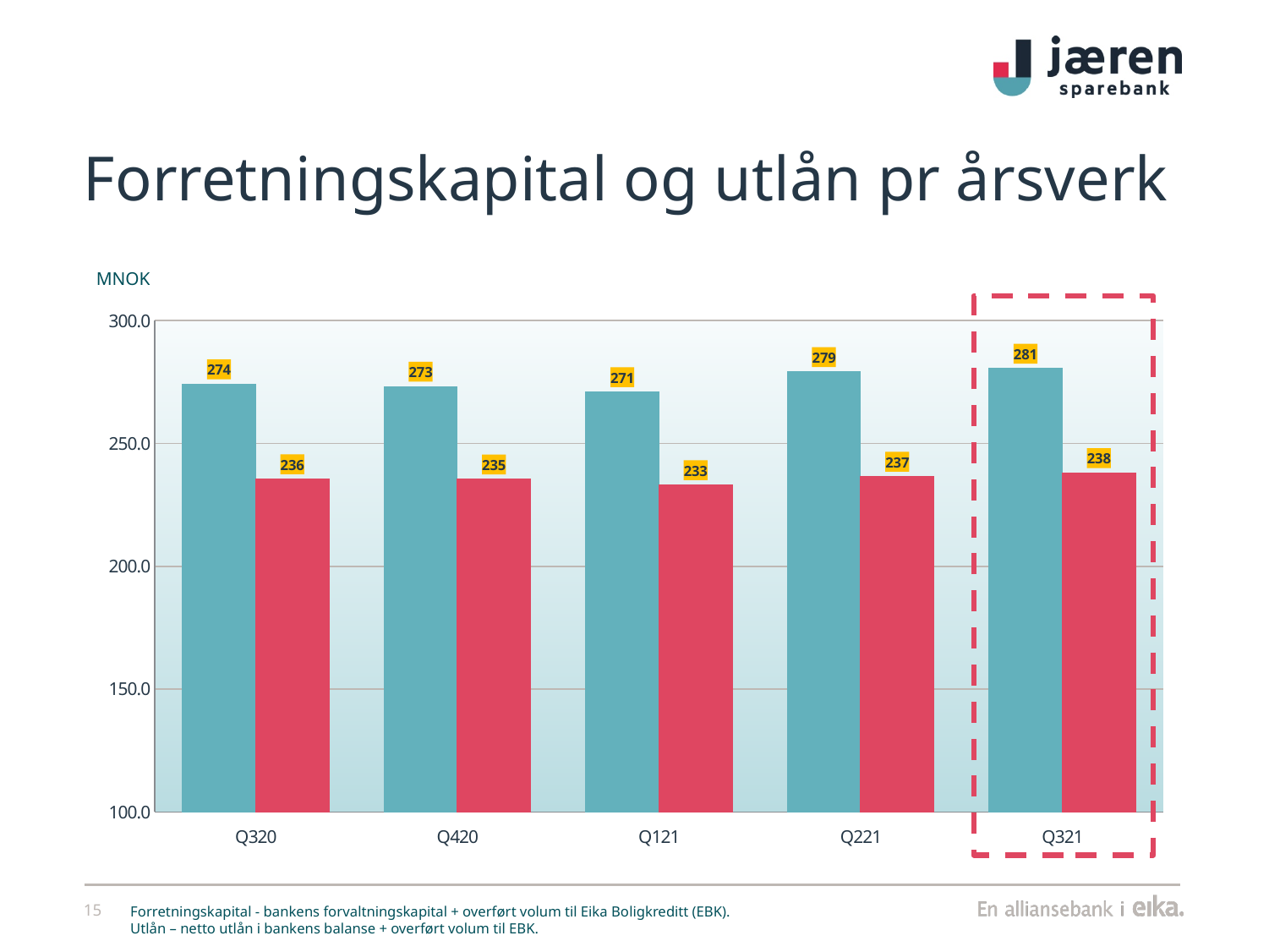
What is the value of the teal bar for Q321? 281 What unit is shown above the chart's y axis? MNOK How many quarters are shown on the x axis? 5 What kind of chart is shown on the slide? Bar chart What is the difference between the teal bar values for Q221 and Q121? 8 Which is larger, the teal bar for Q420 or the teal bar for Q221? Q221 Which quarter has the lowest red bar? Q121 What is the difference between the teal bar and the red bar for Q321? 43 What is the value of the teal bar for Q221? 279 What is the value of the red bar for Q320? 236 What is the value of the red bar for Q121? 233 Which quarter has the highest teal bar? Q321